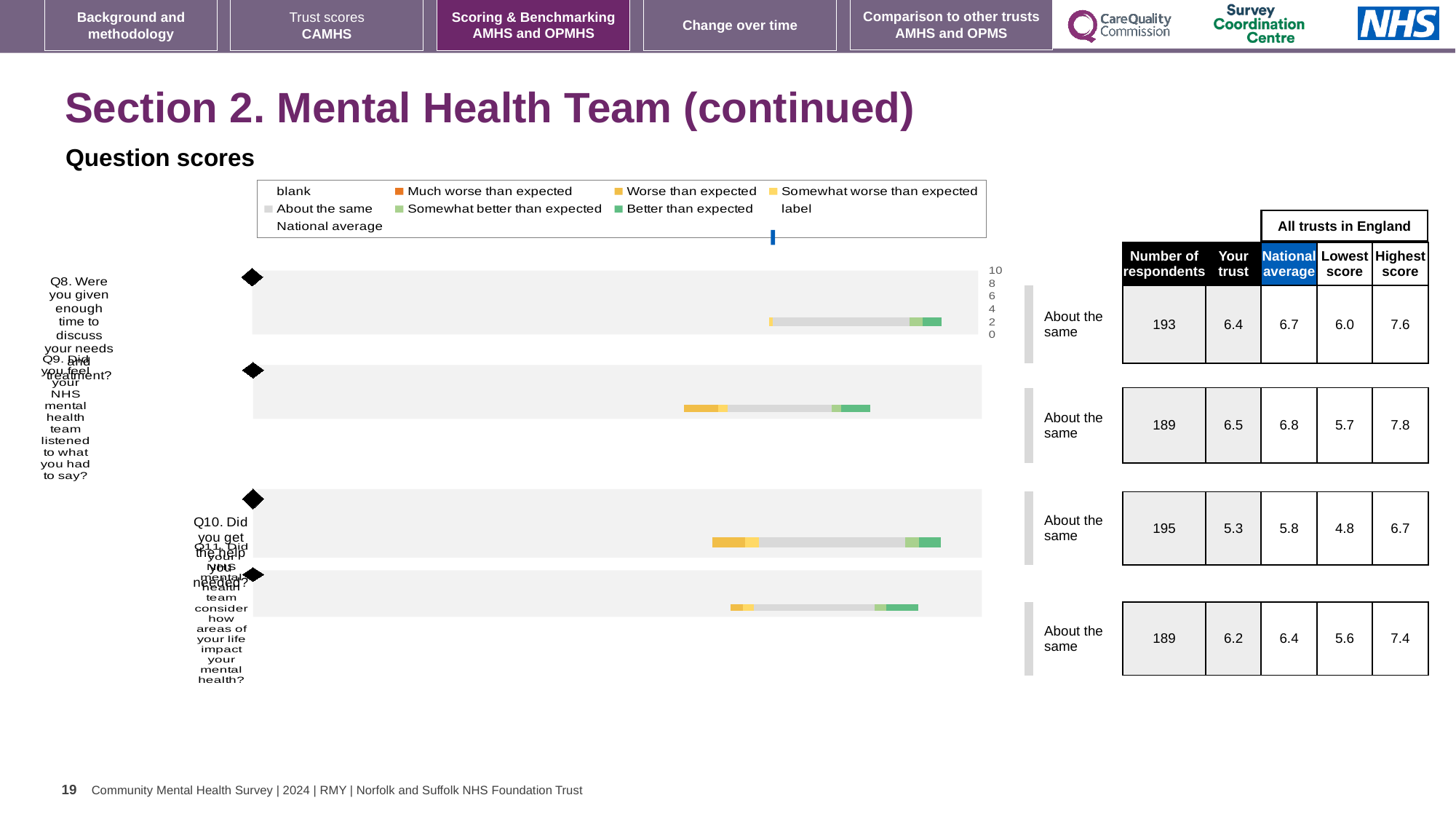
In the table beside the Q10 chart, what is the 'National average' score? 5.8 In the table beside the Q10 chart, how many respondents are listed? 195 In the table beside the Q8 chart, what is the 'Your trust' score? 6.4 How many separate question-score bar charts are shown on the slide? 4 Which question (Q8, Q9, Q10 or Q11) has the highest 'Your trust' score in the table? Q9 In the legend, what colour represents 'Better than expected'? green Which has the larger 'Your trust' score in the table, Q8 or Q11? Q8 Which question (Q8, Q9, Q10 or Q11) has the lowest 'Your trust' score in the table? Q10 How many entries does the legend above the question-score charts list? 9 What kind of chart is used for the question scores on this slide? bar chart In the legend, what colour represents 'Much worse than expected'? orange For Q10, what is the difference between the 'National average' score and the 'Your trust' score in the table? 0.5